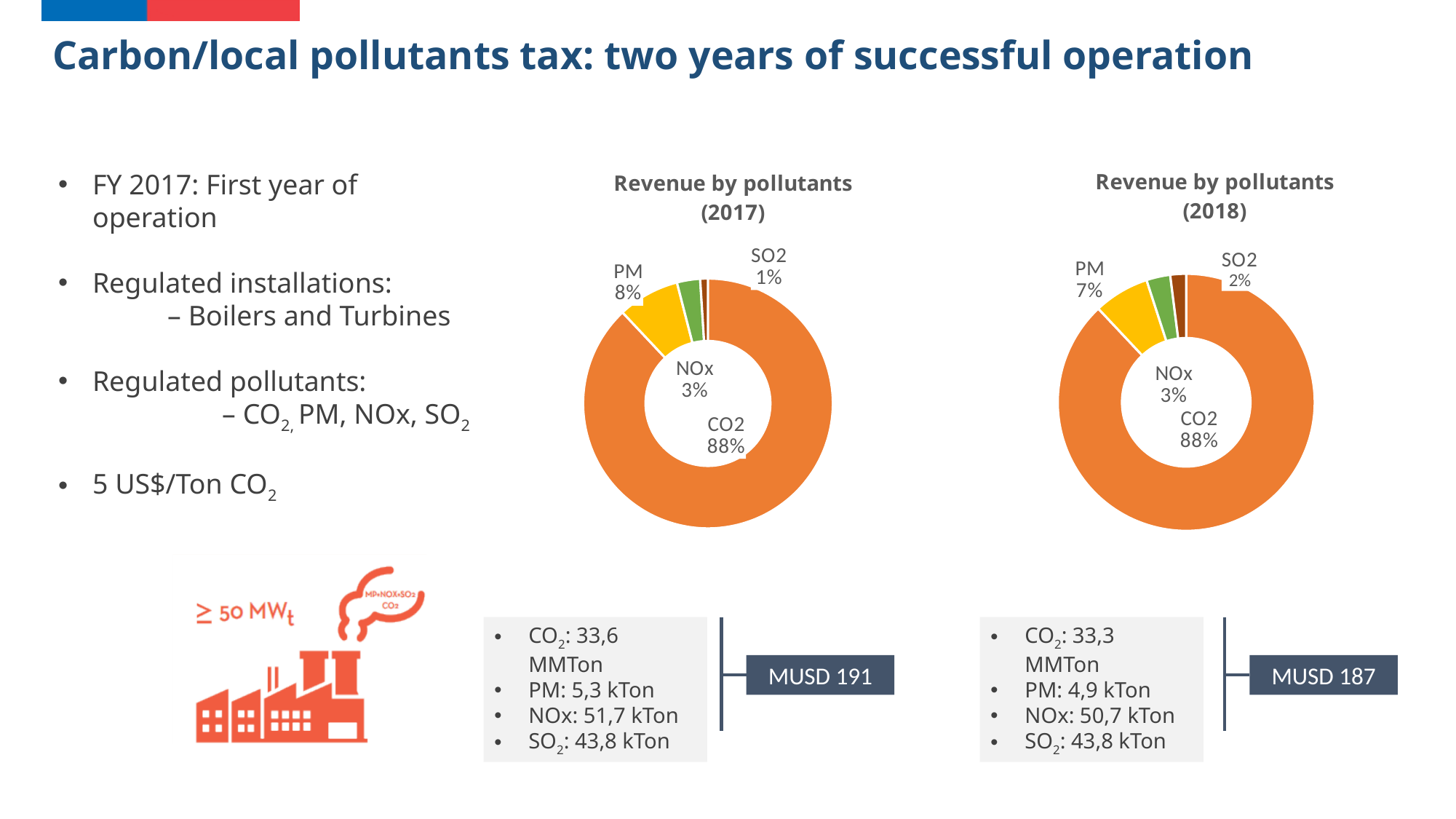
In the 'Revenue by pollutants (2017)' chart, which pollutant has the smallest share? SO2 In the 'Revenue by pollutants (2017)' chart, what colour is the PM slice? Yellow How many pollutant categories are shown in the 'Revenue by pollutants (2017)' chart? 4 What type of chart is 'Revenue by pollutants (2018)'? Pie chart (doughnut) In the 'Revenue by pollutants (2018)' chart, what share of revenue comes from SO2? 2% In the 'Revenue by pollutants (2018)' chart, which pollutant has the smallest share? SO2 In the 'Revenue by pollutants (2017)' chart, which pollutant has the largest share? CO2 In the 'Revenue by pollutants (2017)' chart, what is the difference in percentage points between the PM share and the NOx share? 5 In the 'Revenue by pollutants (2018)' chart, what share of revenue comes from PM? 7% In the 'Revenue by pollutants (2017)' chart, what share of revenue comes from CO2? 88% In the 'Revenue by pollutants (2018)' chart, which is larger, the PM share or the NOx share? PM In the 'Revenue by pollutants (2017)' chart, what share of revenue comes from PM? 8%